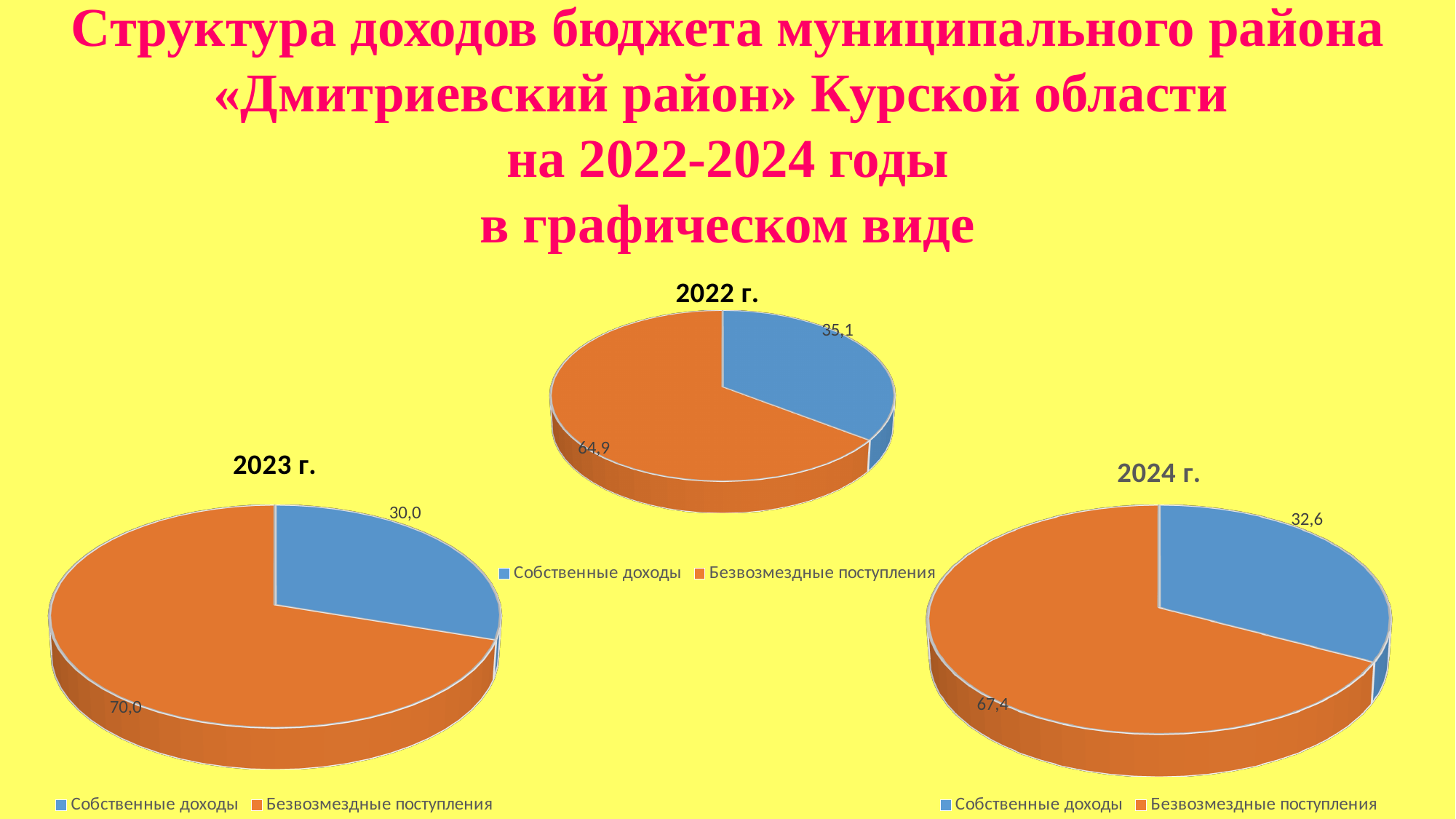
In the "2024 г." pie chart, what is the value for Собственные доходы? 32,6 In the "2024 г." pie chart, what is the value for Безвозмездные поступления? 67,4 How many entries does the legend of the "2024 г." chart list? 2 How many slices does the "2022 г." pie chart have? 2 In the "2023 г." pie chart, what is the value for Собственные доходы? 30,0 In the "2024 г." chart, which slice is larger, Собственные доходы or Безвозмездные поступления? Безвозмездные поступления In the "2022 г." pie chart, what is the value for Собственные доходы? 35,1 In the "2023 г." pie chart, what is the value for Безвозмездные поступления? 70,0 In the "2023 г." chart, what is the difference between Безвозмездные поступления and Собственные доходы? 40,0 In the "2022 г." pie chart, what is the value for Безвозмездные поступления? 64,9 What kind of chart is the "2023 г." chart? Pie chart In the "2022 г." chart, what is the difference between Безвозмездные поступления and Собственные доходы? 29,8